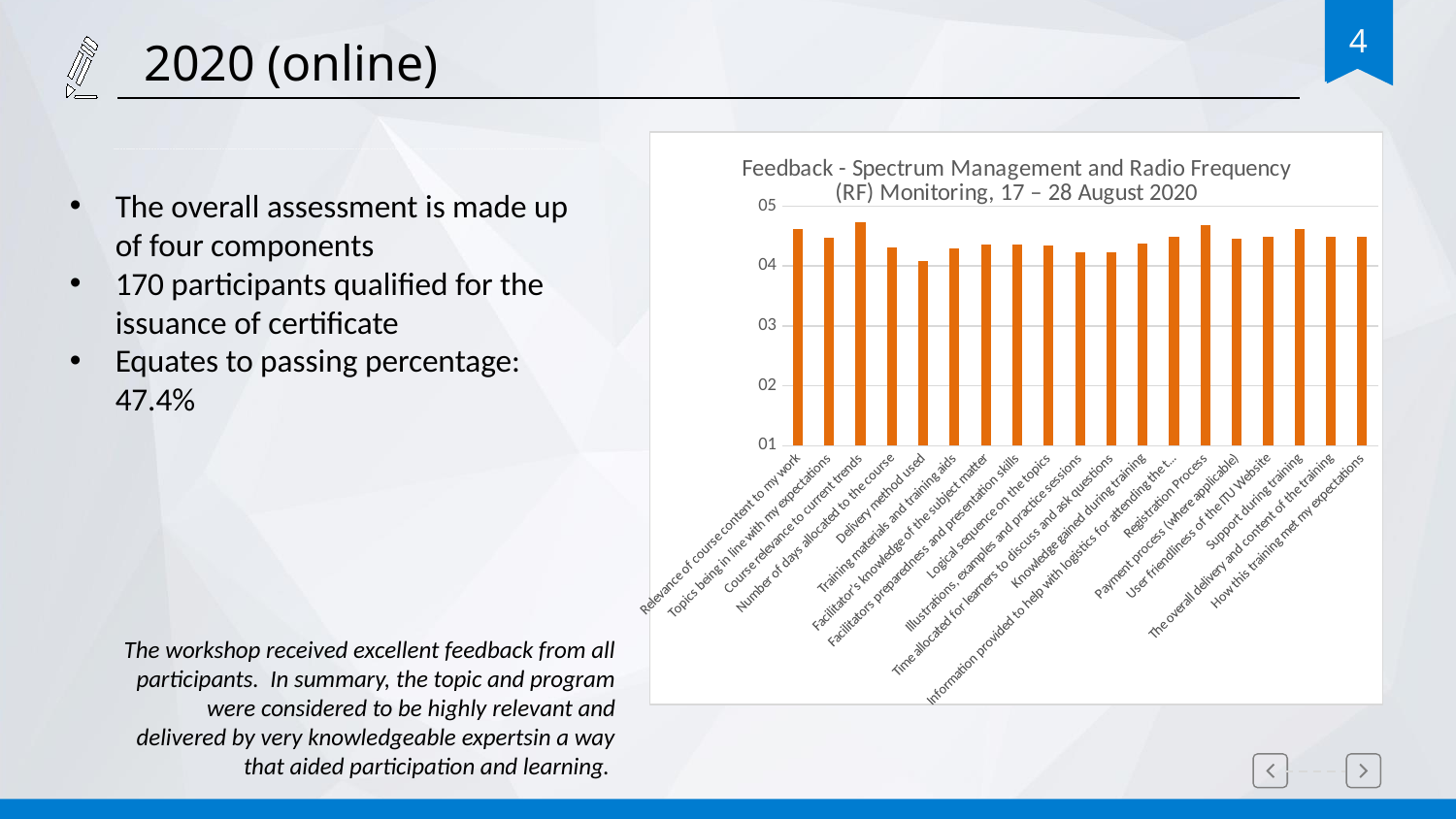
Is the value for "Course relevance to current trends" greater or less than 05? less Is the value for "How this training met my expectations" greater or less than 03? greater What kind of chart is shown on the slide? bar chart Which category has the lowest bar in the chart? Delivery method used Which is larger, the value for "Registration Process" or the value for "Time allocated for learners to discuss and ask questions"? Registration Process How many categories (bars) are plotted in the chart? 19 What colour are the bars in the chart? orange Is the value for "Registration Process" greater or less than 04? greater What is the title of the chart? Feedback - Spectrum Management and Radio Frequency (RF) Monitoring, 17 – 28 August 2020 Which is larger, the value for "Course relevance to current trends" or the value for "Delivery method used"? Course relevance to current trends What is the highest tick value shown on the vertical axis of the chart? 05